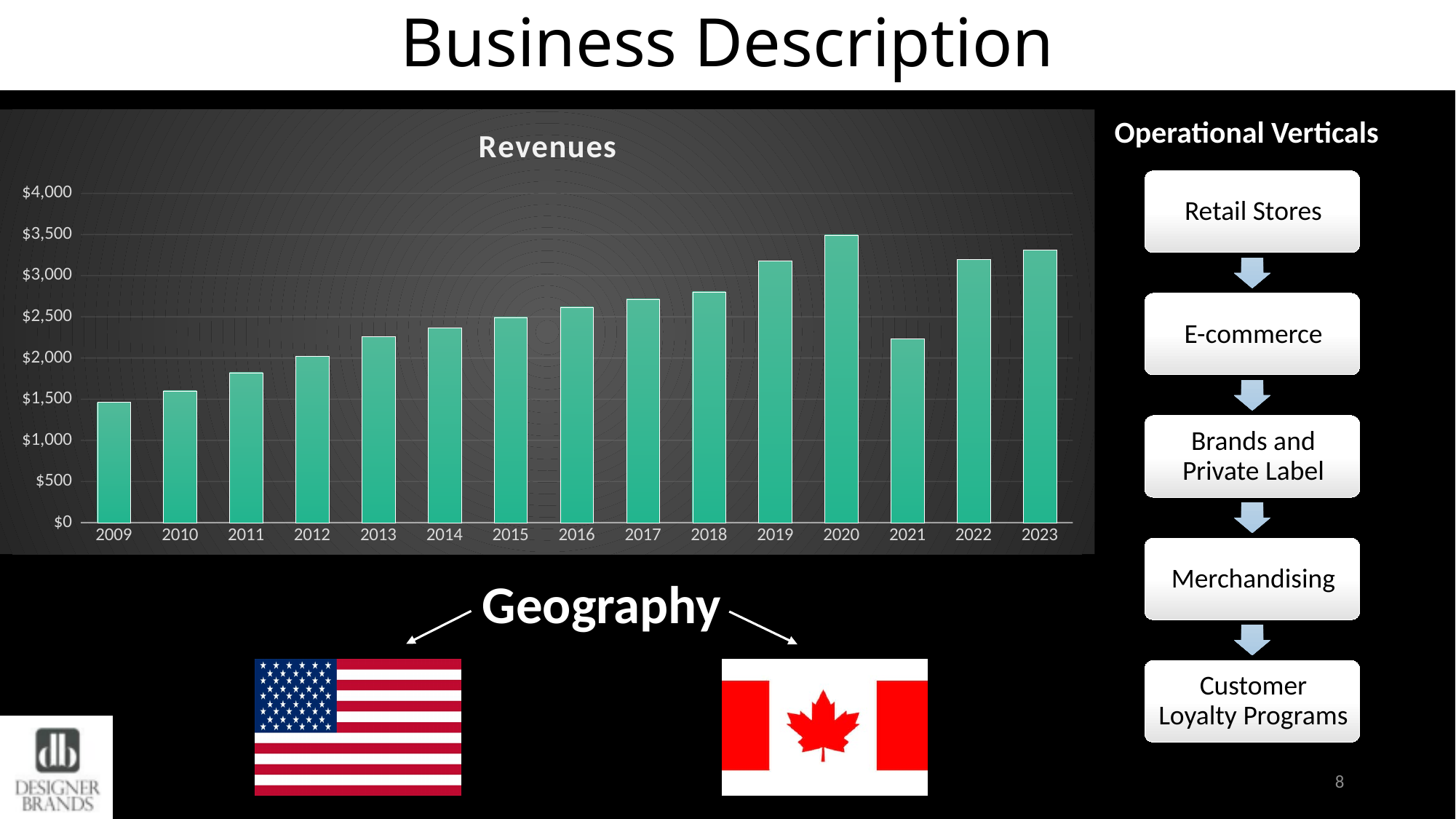
Is the revenue for 2019 greater or less than $3,000? greater Is the revenue for 2021 greater or less than $2,500? less Which year has the highest revenue in the chart? 2020 Which year has the lowest revenue in the chart? 2009 Is the revenue for 2018 greater or less than $3,000? less Which year has the larger revenue, 2020 or 2023? 2020 How many years are plotted on the x axis of the Revenues chart? 15 Do revenues generally rise or fall from 2009 to 2020? rise What is the title of the chart? Revenues What type of chart is shown on the slide? bar chart